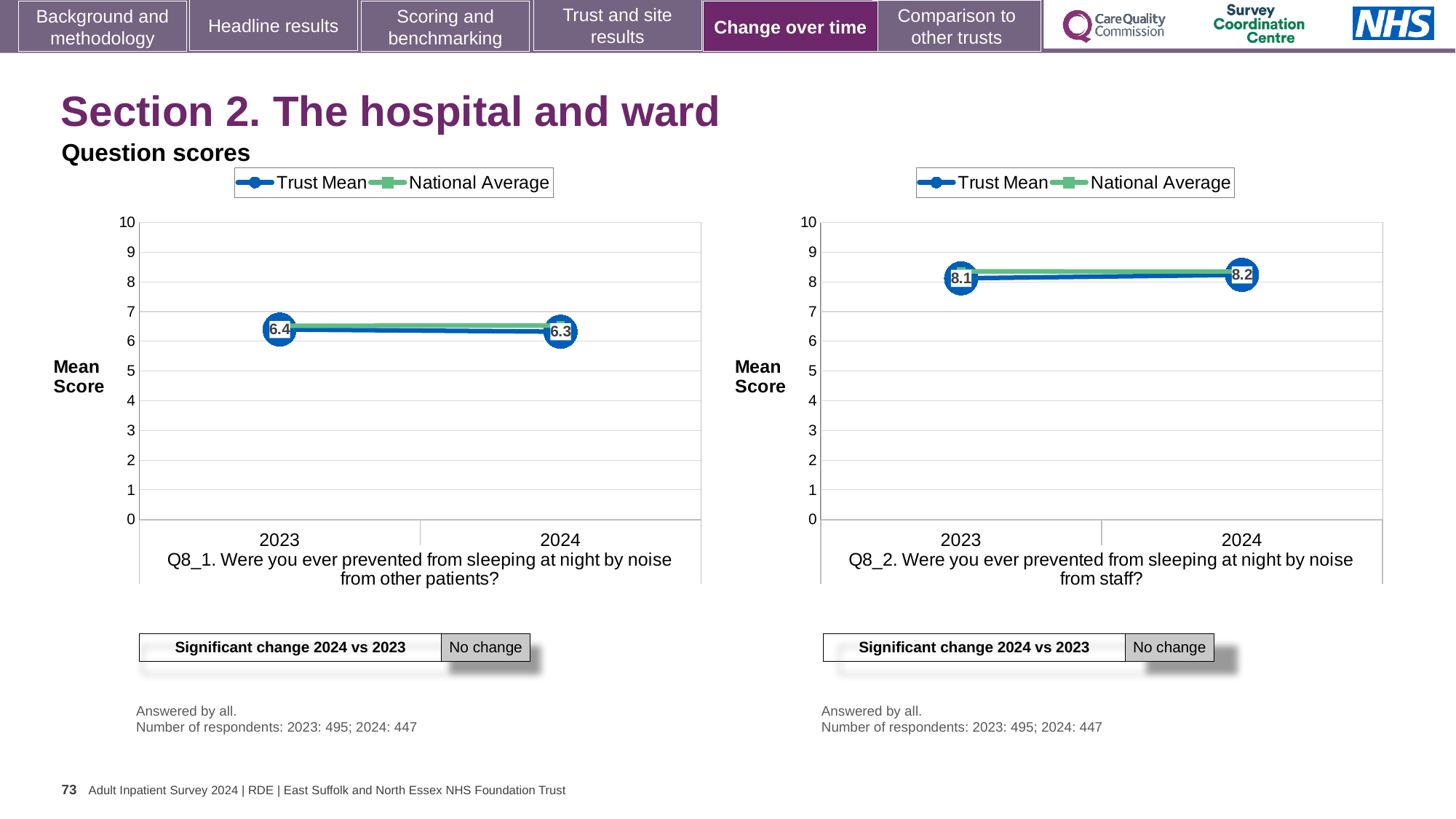
In the right chart (Q8_2), what is the difference between the Trust Mean scores for 2024 and 2023? 0.1 In the right chart (Q8_2), what is the Trust Mean score for 2024? 8.2 In the left chart (Q8_1), is the National Average for 2024 greater or less than 5? greater In the left chart (Q8_1), what is the difference between the Trust Mean scores for 2023 and 2024? 0.1 How many series does the legend of the right chart (Q8_2) list? 2 In the left chart (Q8_1), what is the Trust Mean score for 2024? 6.3 In the left chart (Q8_1), what is the Trust Mean score for 2023? 6.4 How many years are plotted on the x axis of the right chart (Q8_2)? 2 In the left chart (Q8_1), does the Trust Mean rise or fall from 2023 to 2024? fall In the right chart (Q8_2), does the Trust Mean rise or fall from 2023 to 2024? rise In the right chart (Q8_2), what is the Trust Mean score for 2023? 8.1 What kind of chart is the left chart (Q8_1)? line chart